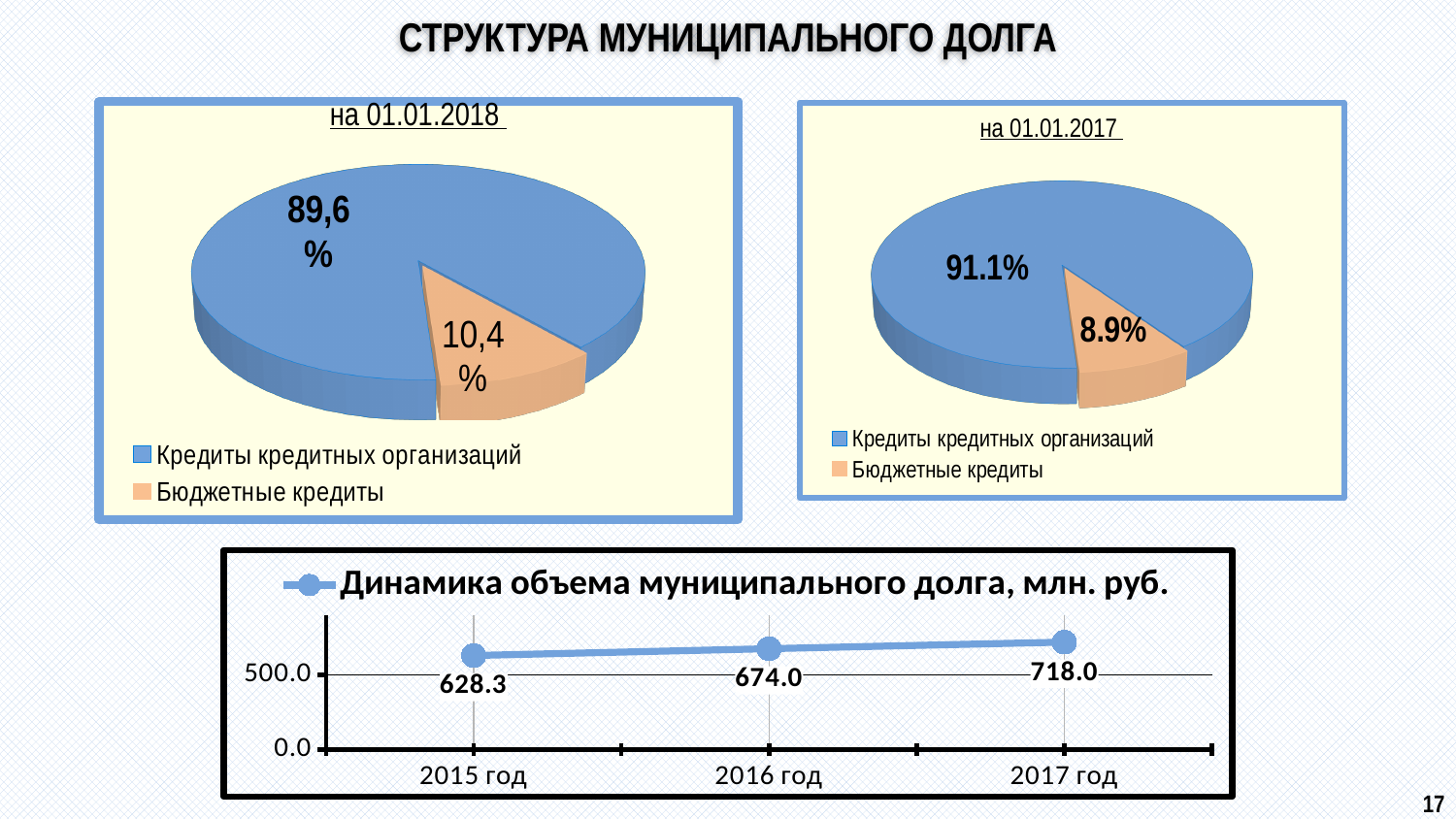
In the pie chart 'на 01.01.2017', what share is shown for Бюджетные кредиты? 8.9% In the line chart 'Динамика объема муниципального долга, млн. руб.', what is the value for 2015 год? 628.3 In the pie chart 'на 01.01.2018', which category has the smallest slice? Бюджетные кредиты In the pie chart 'на 01.01.2018', what share is shown for Бюджетные кредиты? 10,4% In the line chart 'Динамика объема муниципального долга, млн. руб.', how many data points are plotted? 3 In the pie chart 'на 01.01.2018', what share is shown for Кредиты кредитных организаций? 89,6% In the pie chart 'на 01.01.2017', which category has the largest slice? Кредиты кредитных организаций In the line chart 'Динамика объема муниципального долга, млн. руб.', do the values rise or fall from 2015 год to 2017 год? rise In the line chart 'Динамика объема муниципального долга, млн. руб.', what is the value for 2017 год? 718.0 In the line chart 'Динамика объема муниципального долга, млн. руб.', what is the difference between the values for 2017 год and 2015 год? 89.7 What kind of chart is the chart at the bottom of the slide? line chart